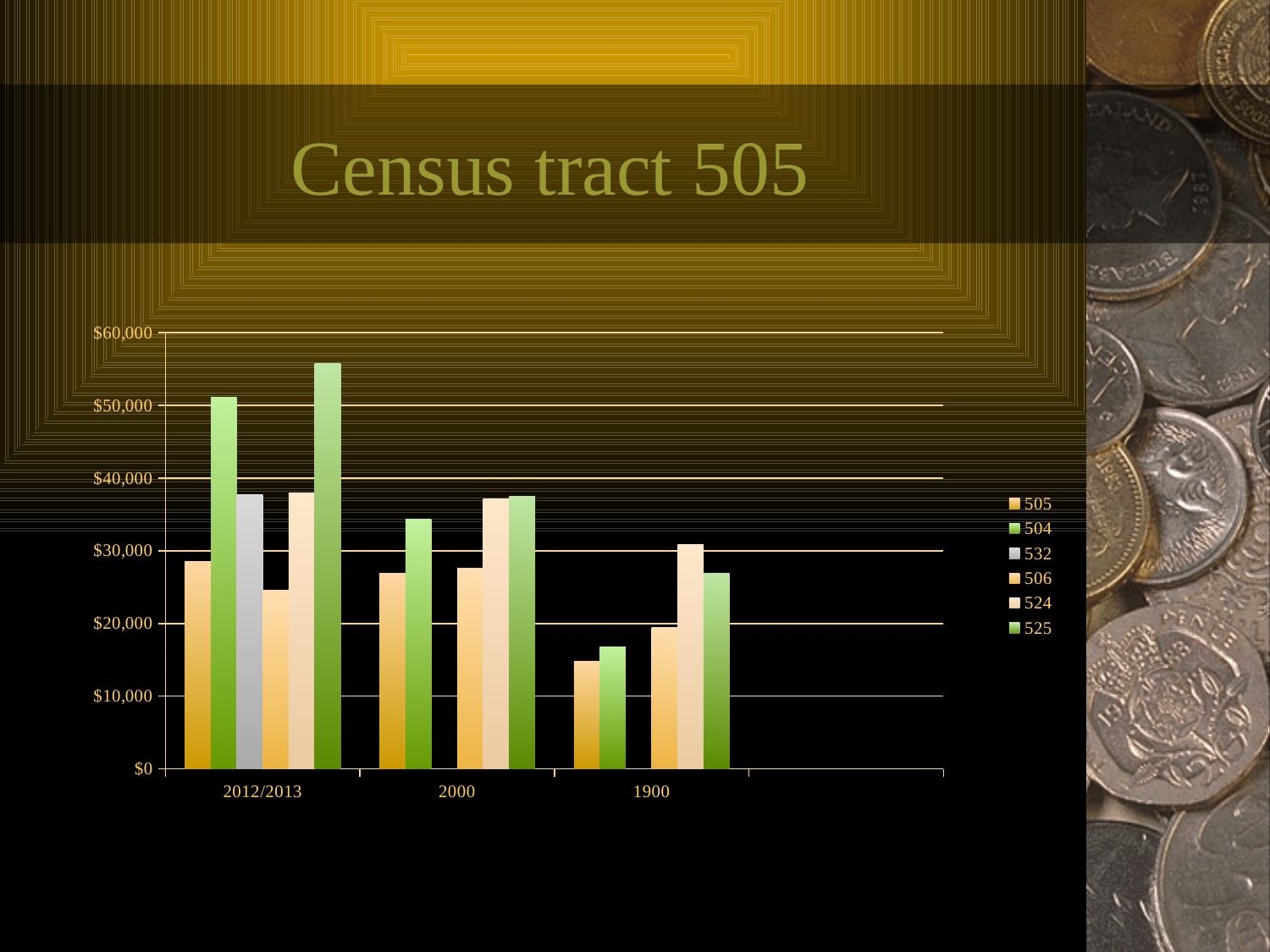
What kind of chart is shown on the slide? bar chart What is the title of the chart? Census tract 505 Is the value for series 525 in 2012/2013 greater or less than $50,000? greater How many series does the legend list? 6 Is the value for series 505 in 1900 greater or less than $20,000? less Is the value for series 532 in 2012/2013 greater or less than $40,000? less In the 2012/2013 category, which is larger, the value for series 504 or series 505? 504 Do the values for series 525 rise or fall moving from 2012/2013 to 1900 along the x axis? fall Which series has the highest value in the 2012/2013 category? 525 How many categories are shown on the x axis? 3 Which series has the lowest value in the 2012/2013 category? 506 Which series has the highest value in the 1900 category? 524